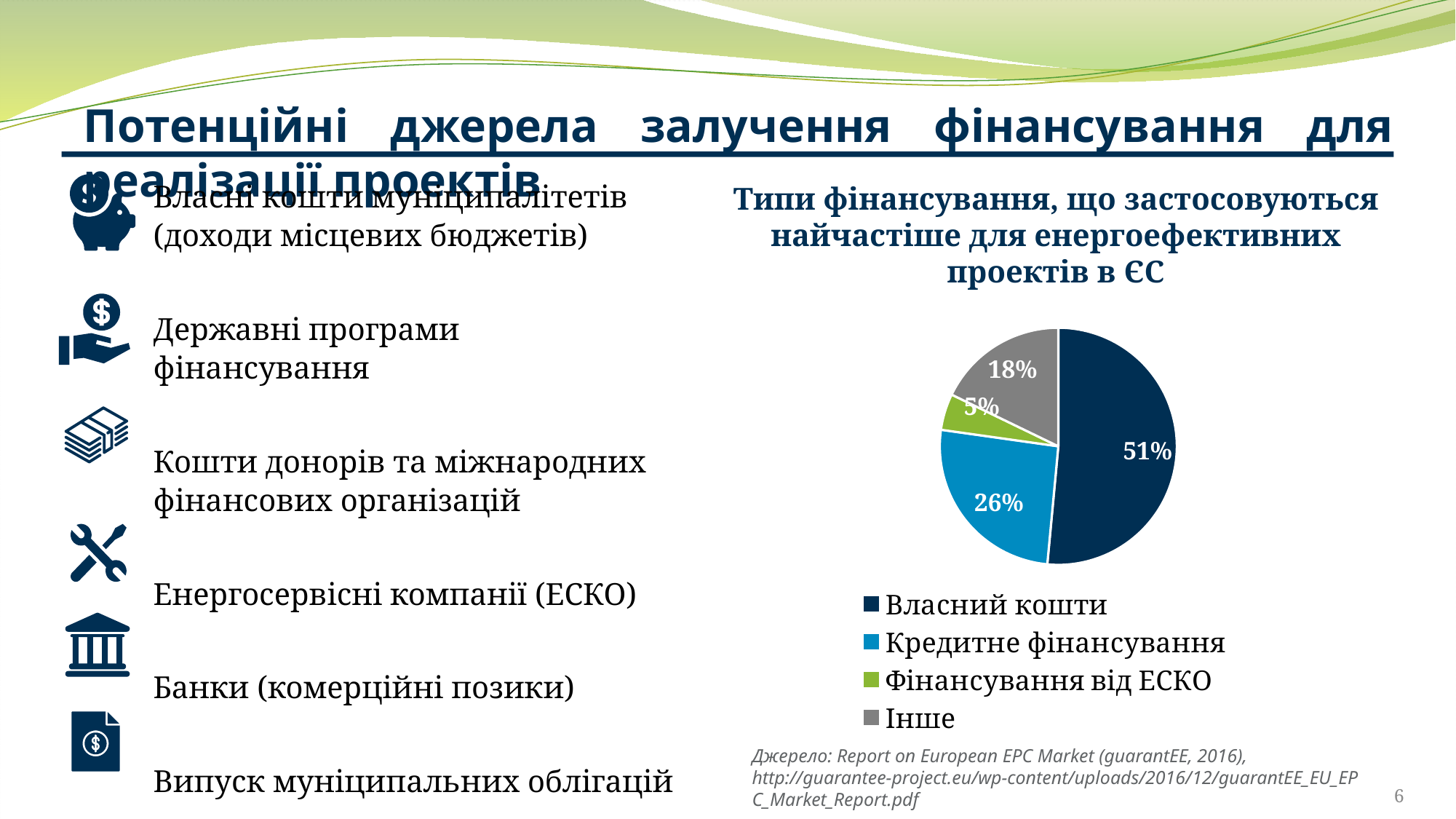
Which category has the largest slice of the pie? Власний кошти Which is larger: the share for "Інше" or the share for "Фінансування від ЕСКО"? Інше What is the difference in percentage points between "Власний кошти" and "Кредитне фінансування"? 25 What share of the pie does "Фінансування від ЕСКО" have? 5% What type of chart is shown on the slide? Pie chart How many slices does the pie chart have? 4 What share of the pie does "Власний кошти" have? 51% What colour is the slice for "Кредитне фінансування"? Light blue What share of the pie does "Кредитне фінансування" have? 26% What share of the pie does "Інше" have? 18% Which category has the smallest slice of the pie? Фінансування від ЕСКО How many entries does the legend list? 4